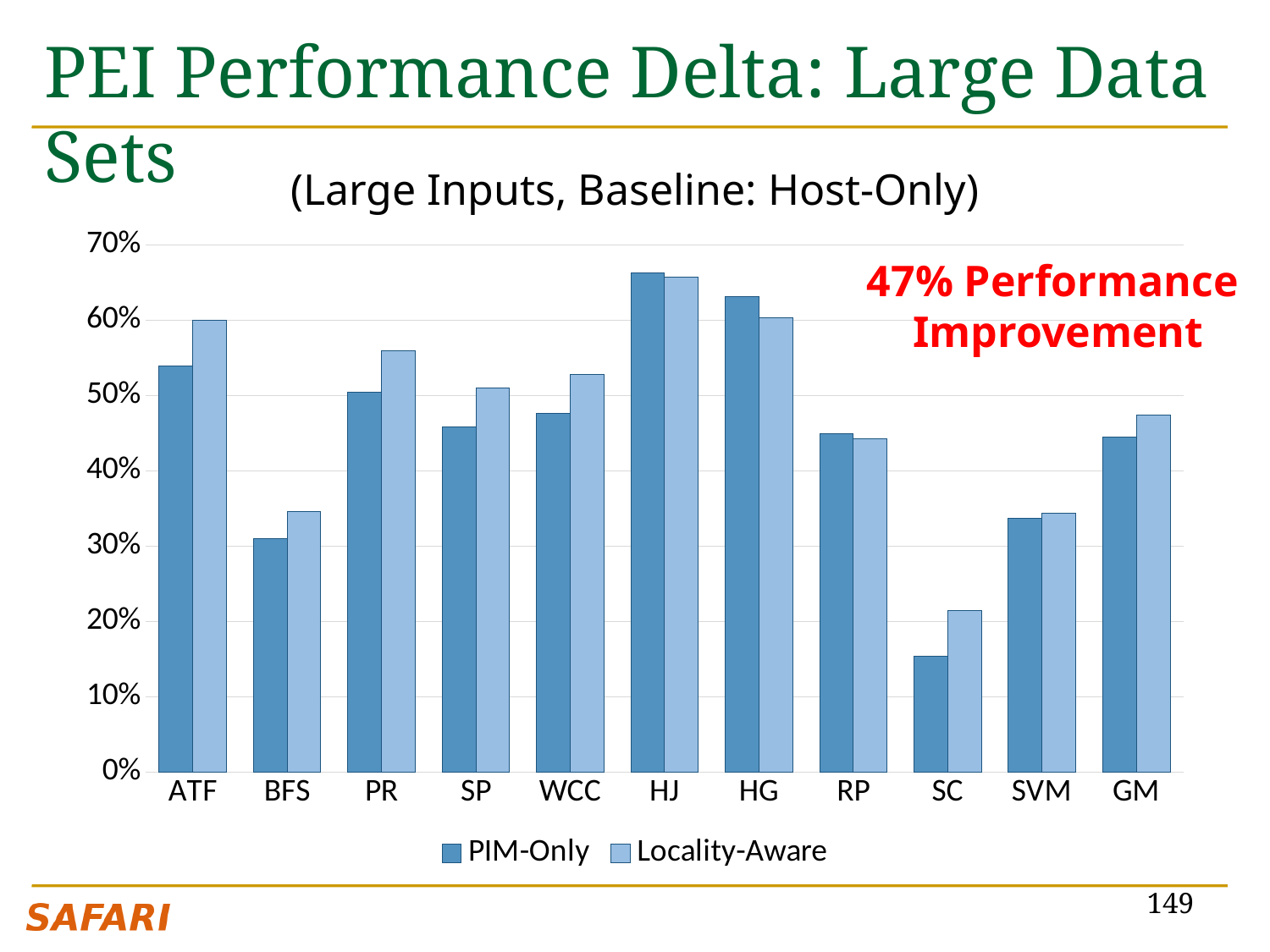
Which category has the highest PIM-Only value? HJ For HG, which series has the larger value, PIM-Only or Locality-Aware? PIM-Only How many categories are shown along the x axis of the chart? 11 Is the PIM-Only value for ATF greater or less than 50%? greater What are the two series named in the chart's legend? PIM-Only and Locality-Aware What kind of chart is shown on the slide? bar chart For ATF, which series has the larger value, PIM-Only or Locality-Aware? Locality-Aware Is the Locality-Aware value for BFS greater or less than 30%? greater Which category has the lowest PIM-Only value? SC How many series does the chart's legend list? 2 Is the PIM-Only value for SC greater or less than 20%? less Which category has the lowest Locality-Aware value? SC